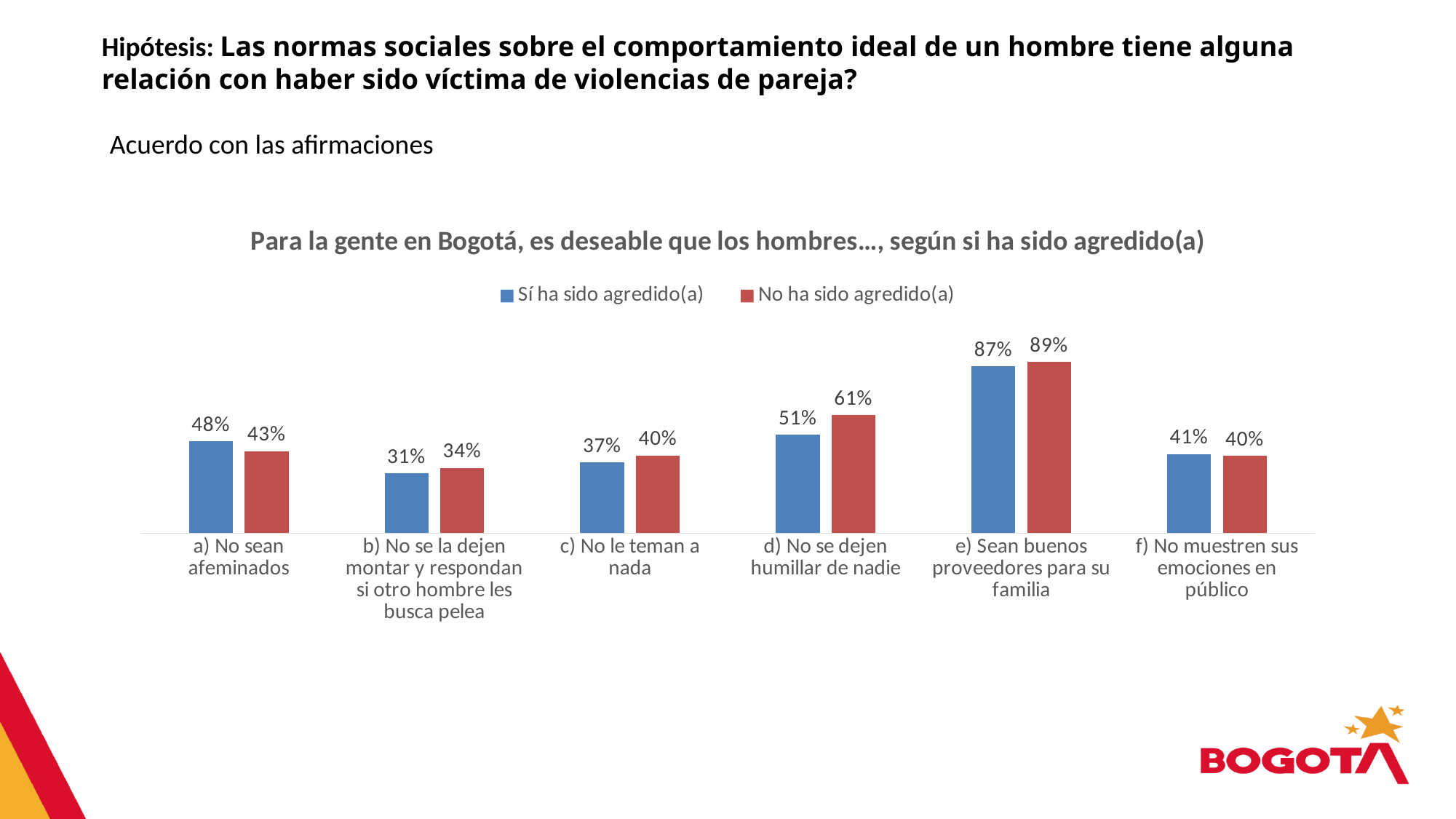
What is the value for 'Sí ha sido agredido(a)' in category 'e) Sean buenos proveedores para su familia'? 87% How many categories are shown on the x axis? 6 What is the value for 'Sí ha sido agredido(a)' in category 'a) No sean afeminados'? 48% What kind of chart is shown on the slide? Bar chart In category 'a) No sean afeminados', which series has the larger value? Sí ha sido agredido(a) What colour represents the series 'No ha sido agredido(a)'? Red Which category has the lowest value for 'Sí ha sido agredido(a)'? b) No se la dejen montar y respondan si otro hombre les busca pelea What is the value for 'No ha sido agredido(a)' in category 'd) No se dejen humillar de nadie'? 61% How many series does the legend list? 2 Which category has the highest value for 'No ha sido agredido(a)'? e) Sean buenos proveedores para su familia What is the difference between 'No ha sido agredido(a)' and 'Sí ha sido agredido(a)' in category 'd) No se dejen humillar de nadie'? 10% What is the difference between 'Sí ha sido agredido(a)' and 'No ha sido agredido(a)' in category 'f) No muestren sus emociones en público'? 1%